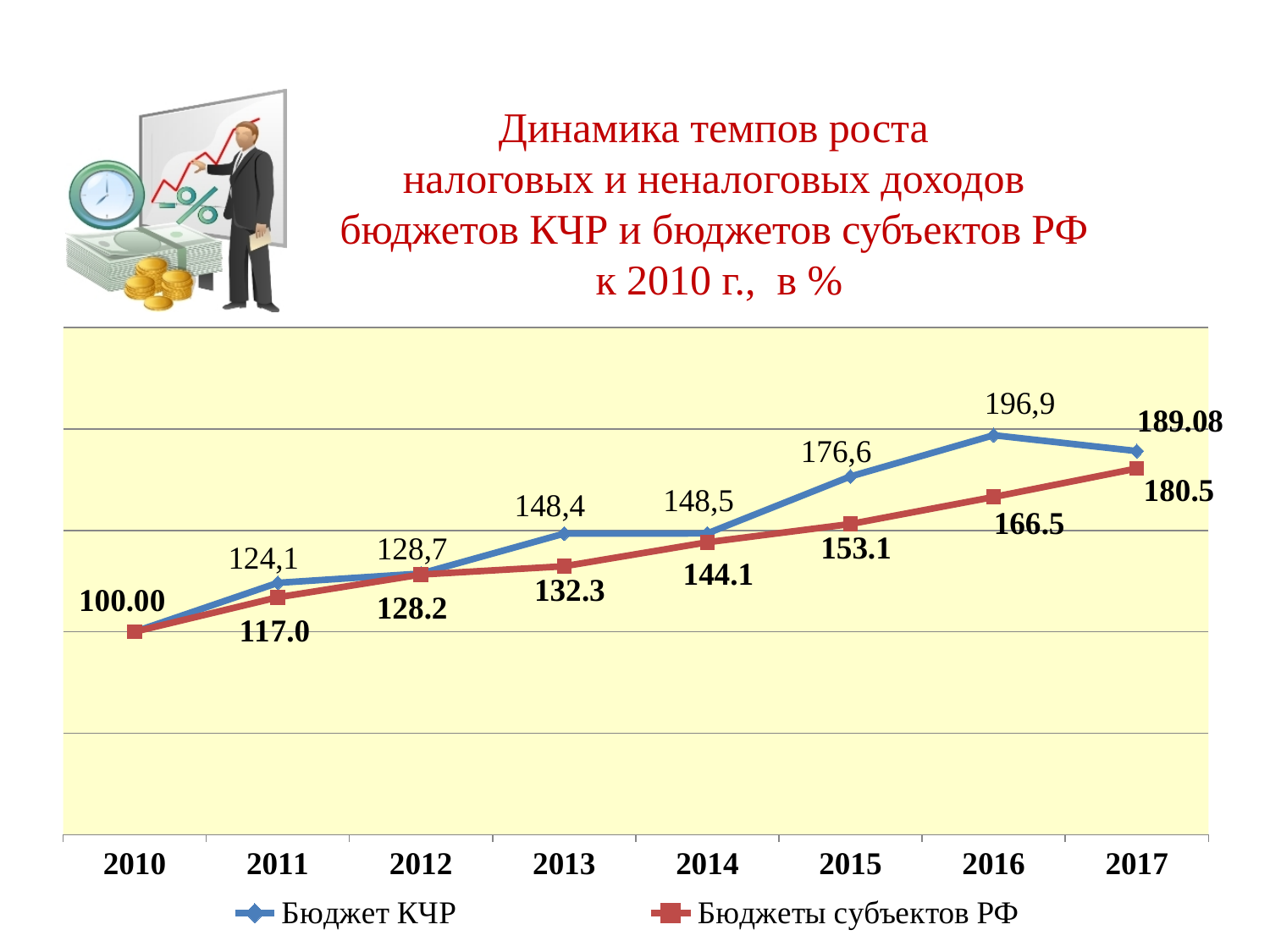
In which year does the Бюджет КЧР series reach its highest value? 2016 What is the value for Бюджеты субъектов РФ in 2015? 153.1 What kind of chart is shown on the slide? line chart How many series does the legend list? 2 What is the value for Бюджеты субъектов РФ in 2017? 180.5 In which year does the Бюджеты субъектов РФ series reach its highest value? 2017 What is the difference between Бюджет КЧР and Бюджеты субъектов РФ in 2016? 30.4 What is the value for Бюджет КЧР in 2016? 196,9 How many years are shown on the x axis? 8 Which series has the larger value in 2015, Бюджет КЧР or Бюджеты субъектов РФ? Бюджет КЧР In which year is the value for Бюджет КЧР lowest? 2010 What is the value for Бюджет КЧР in 2013? 148,4